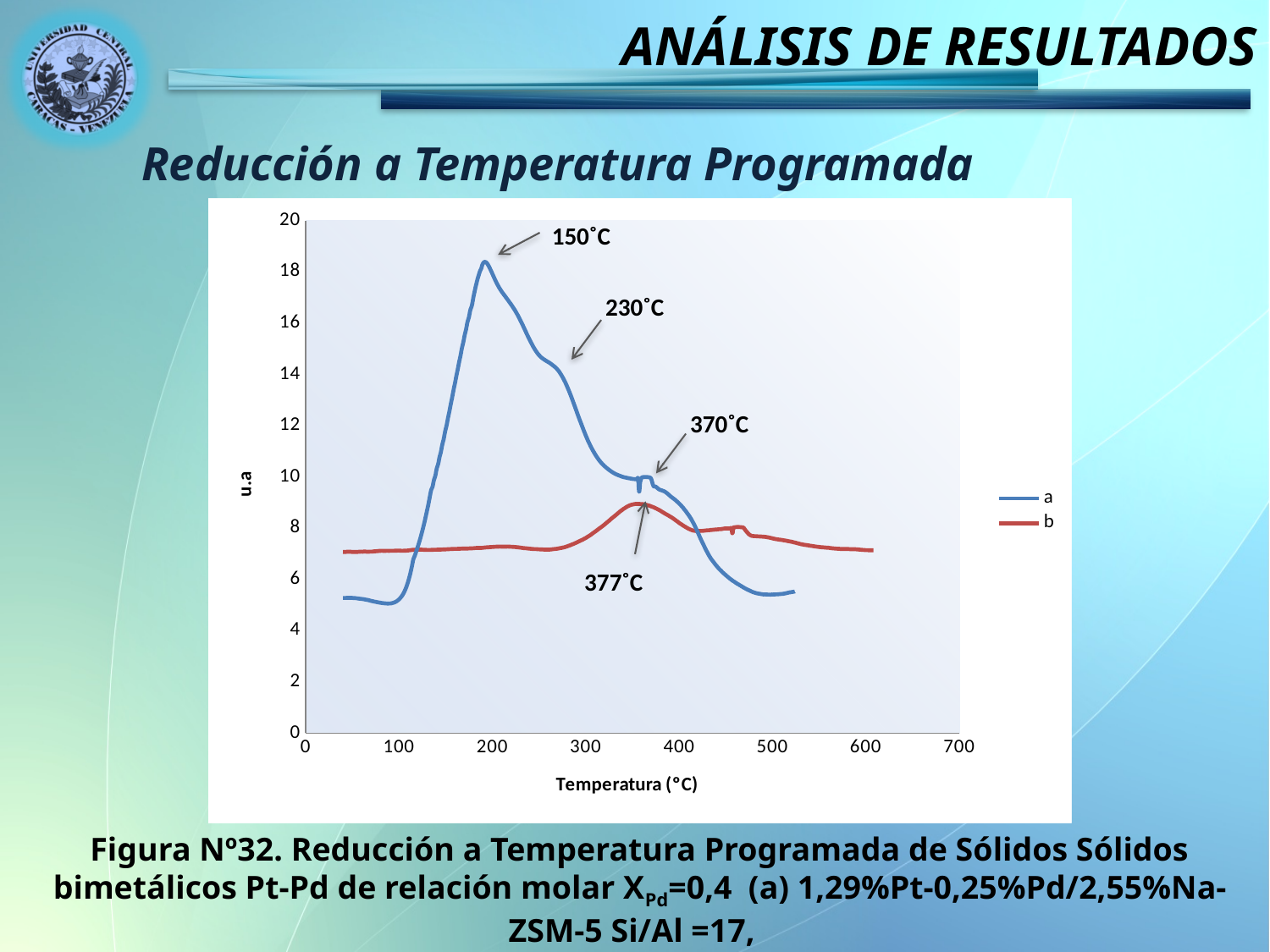
Does series a rise or fall between 200 °C and 500 °C? fall Which series reaches the higher peak value, a or b? a What kind of chart is shown on the slide? line chart What are the names of the series listed in the legend? a and b Is the maximum value of series a greater or less than 16? greater What temperature is annotated at the peak of series b? 377˚C Is the value of series a at 100 °C greater or less than 6? less How many series does the legend list? 2 What temperature is annotated at the highest peak of series a? 150˚C What is the label of the x axis? Temperatura (°C) Is the maximum value of series b greater or less than 10? less What temperature is annotated at the shoulder of series a between its main peak and the 370˚C feature? 230˚C